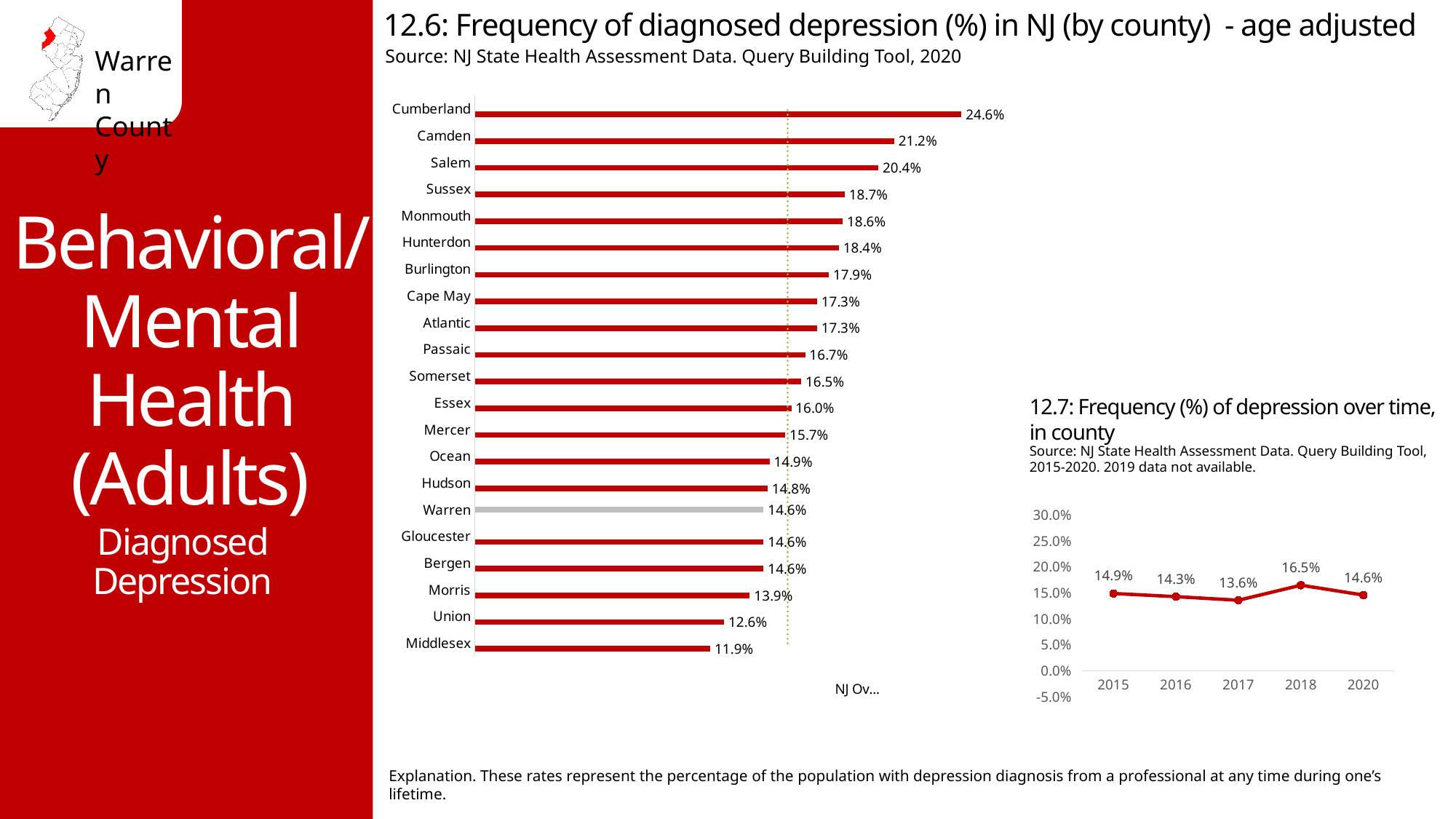
In chart 12.6 (frequency of diagnosed depression by county), which county has the lowest value? Middlesex In chart 12.6 (frequency of diagnosed depression by county), what is the value for Warren? 14.6% What kind of chart is chart 12.6 (frequency of diagnosed depression by county)? Bar chart In chart 12.6 (frequency of diagnosed depression by county), which county has the highest value? Cumberland In chart 12.7 (frequency of depression over time), which year has the lowest value? 2017 In chart 12.6 (frequency of diagnosed depression by county), what is the value for Cumberland? 24.6% In chart 12.6 (frequency of diagnosed depression by county), how many counties are plotted? 21 In chart 12.6 (frequency of diagnosed depression by county), what is the difference between Camden and Salem? 0.8% In chart 12.6 (frequency of diagnosed depression by county), which is larger, Passaic or Mercer? Passaic In chart 12.7 (frequency of depression over time), what is the difference between 2018 and 2020? 1.9% In chart 12.7 (frequency of depression over time), what is the value for 2018? 16.5% What kind of chart is chart 12.7 (frequency of depression over time)? Line chart